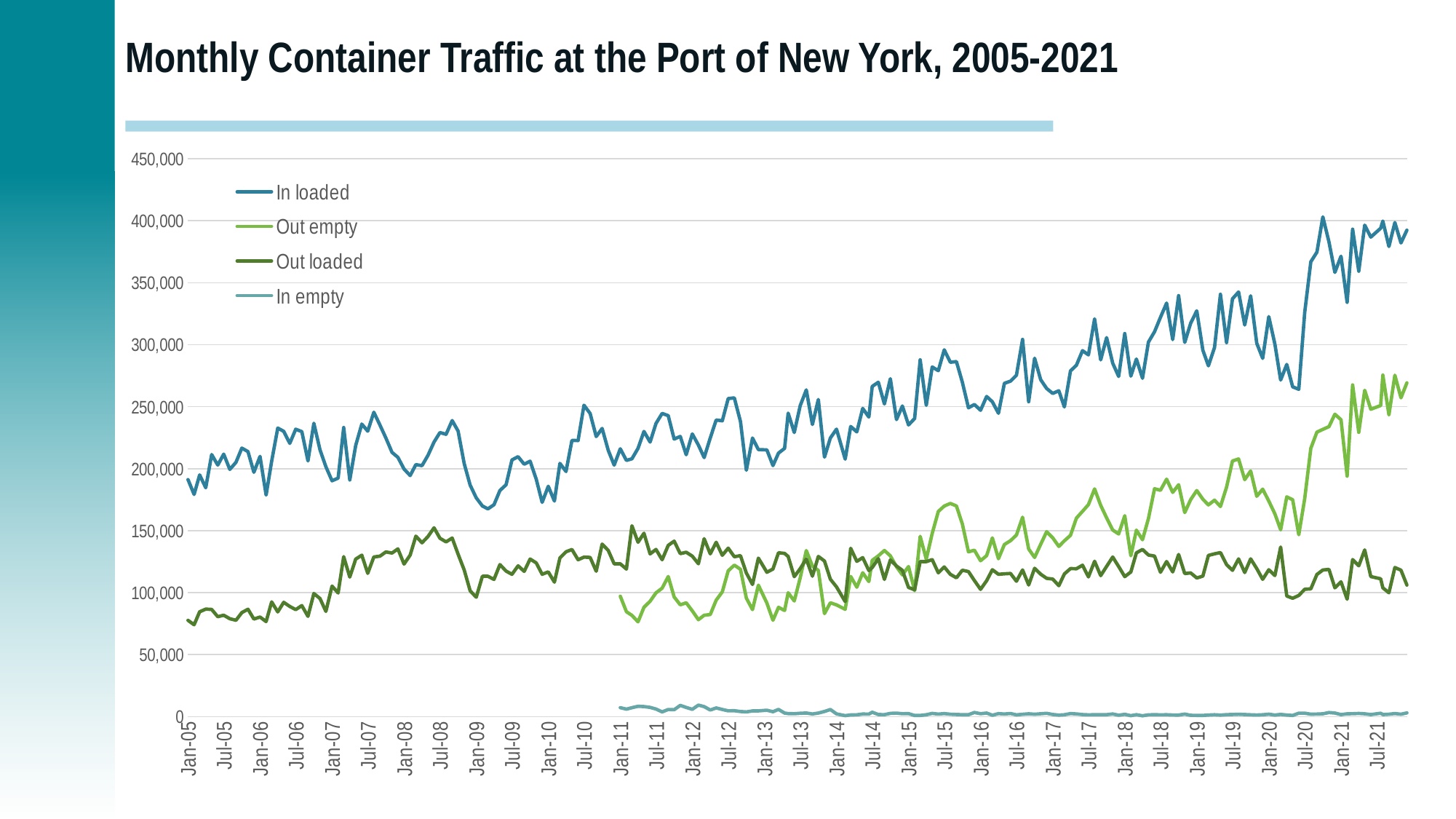
Is the value for Out empty at Jul-21 greater or less than 200,000? greater How many series does the legend list? 4 Is the value for In loaded at Jan-05 greater or less than 150,000? greater At Jan-15, which series has the larger value, In loaded or Out loaded? In loaded Is the value for Out loaded at Jan-05 greater or less than 100,000? less What kind of chart is shown on the slide? Line chart Which series has the highest values across the whole chart? In loaded Overall, does the In loaded series rise or fall from 2005 to 2021? Rise Which series is plotted in light green? Out empty Which series has the lowest values across the whole chart? In empty What is the title of the chart? Monthly Container Traffic at the Port of New York, 2005-2021